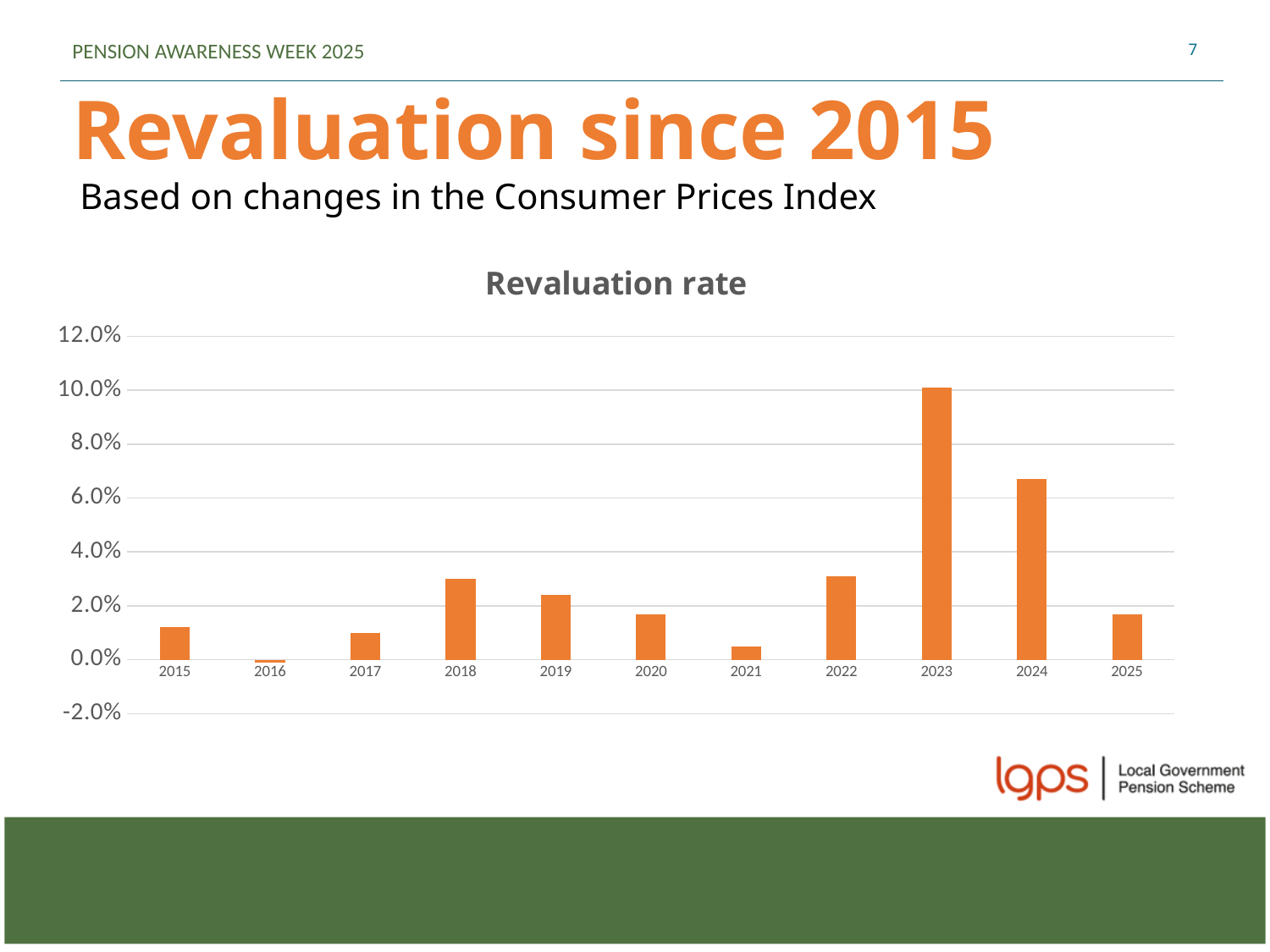
What is the title of the chart? Revaluation rate Which year has the higher revaluation rate, 2021 or 2022? 2022 Is the revaluation rate for 2018 greater or less than 2.0%? greater What colour are the bars in the chart? Orange Which year has the lowest revaluation rate? 2016 Is the revaluation rate for 2021 greater or less than 2.0%? less Is the revaluation rate for 2024 greater or less than 6.0%? greater What kind of chart is shown on the slide? Bar chart Which year has the higher revaluation rate, 2023 or 2024? 2023 Which year has the highest revaluation rate? 2023 How many years are shown on the x axis of the chart? 11